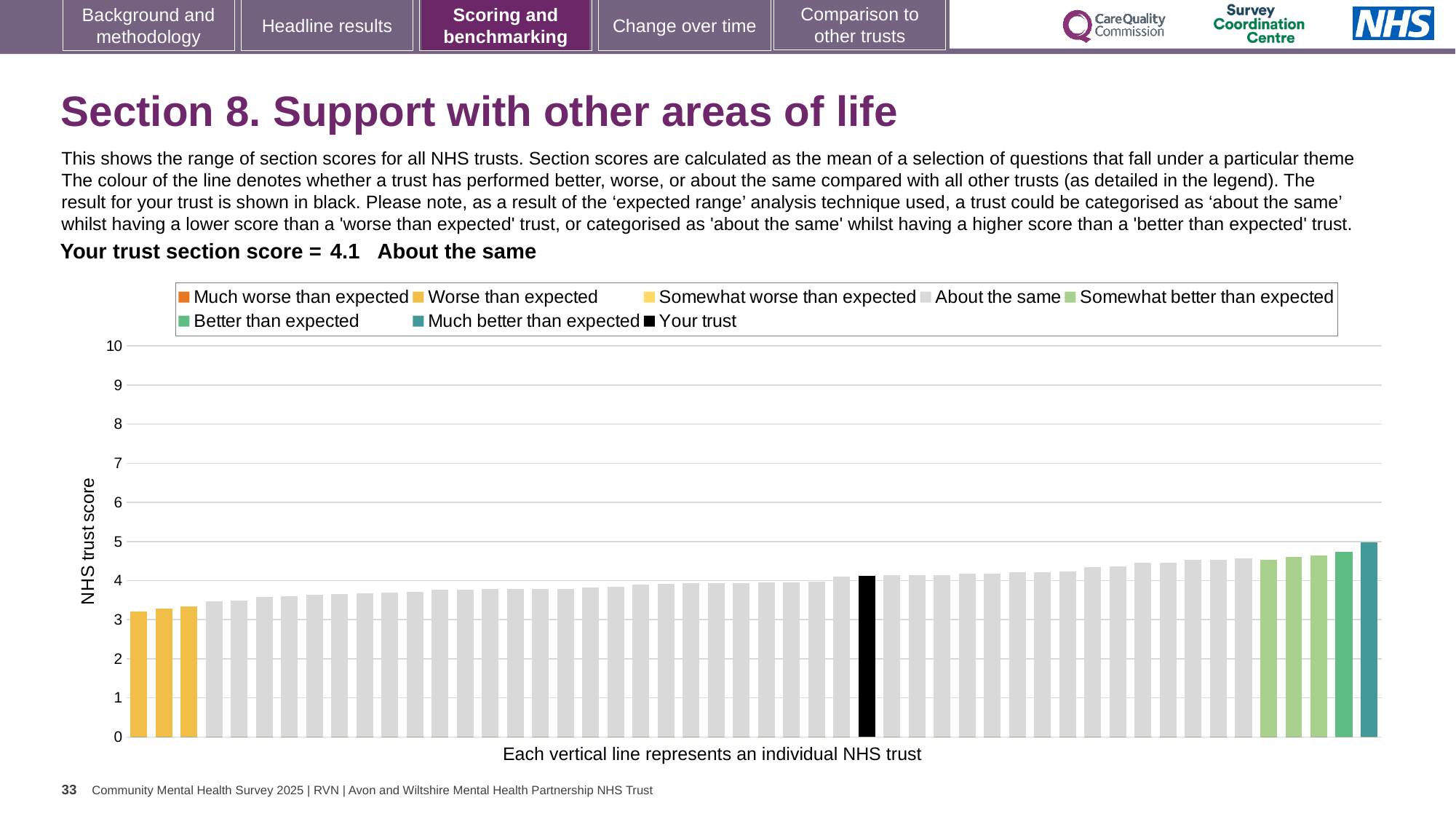
How many entries does the legend list? 8 What is the section score for your trust? 4.1 How many bars are coloured as 'Worse than expected'? 3 Which legend category does the lowest bar belong to? Worse than expected Is the value for your trust greater or less than 4? greater Do the bar values rise or fall from left to right along the x axis? Rise Is the value of the rightmost (highest) bar greater or less than 6? less Which legend category does the highest bar belong to? Much better than expected Is the value of the leftmost (lowest) bar greater or less than 4? less How many bars are coloured as 'Much better than expected'? 1 What is the label on the y axis? NHS trust score What kind of chart is shown on the slide? Bar chart